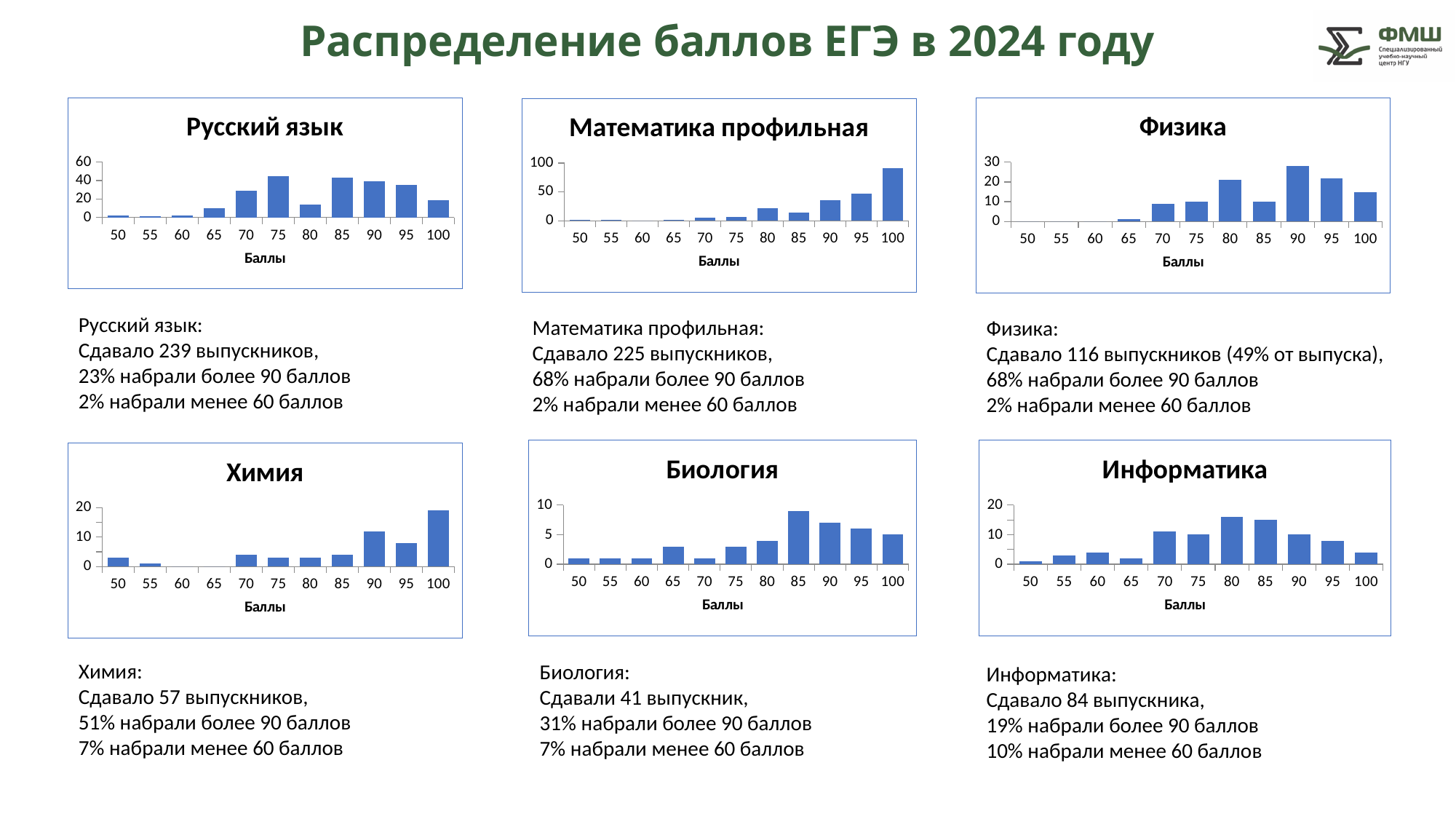
In the "Физика" chart, which score category has the highest bar? 90 What is the x-axis title on the "Химия" chart? Баллы In the "Информатика" chart, is the value for 100 greater or less than 10? less In the "Математика профильная" chart, do the values generally rise or fall as the score increases along the x axis? rise In the "Математика профильная" chart, is the value for 90 greater or less than 50? less In the "Химия" chart, which score category has the highest bar? 100 In the "Русский язык" chart, is the value for 75 greater or less than 40? greater In the "Математика профильная" chart, which score category has the highest bar? 100 How many score categories are shown on the x axis of the "Физика" chart? 11 What kind of chart is the "Русский язык" chart? bar chart In the "Биология" chart, which is larger, the value for 85 or the value for 100? 85